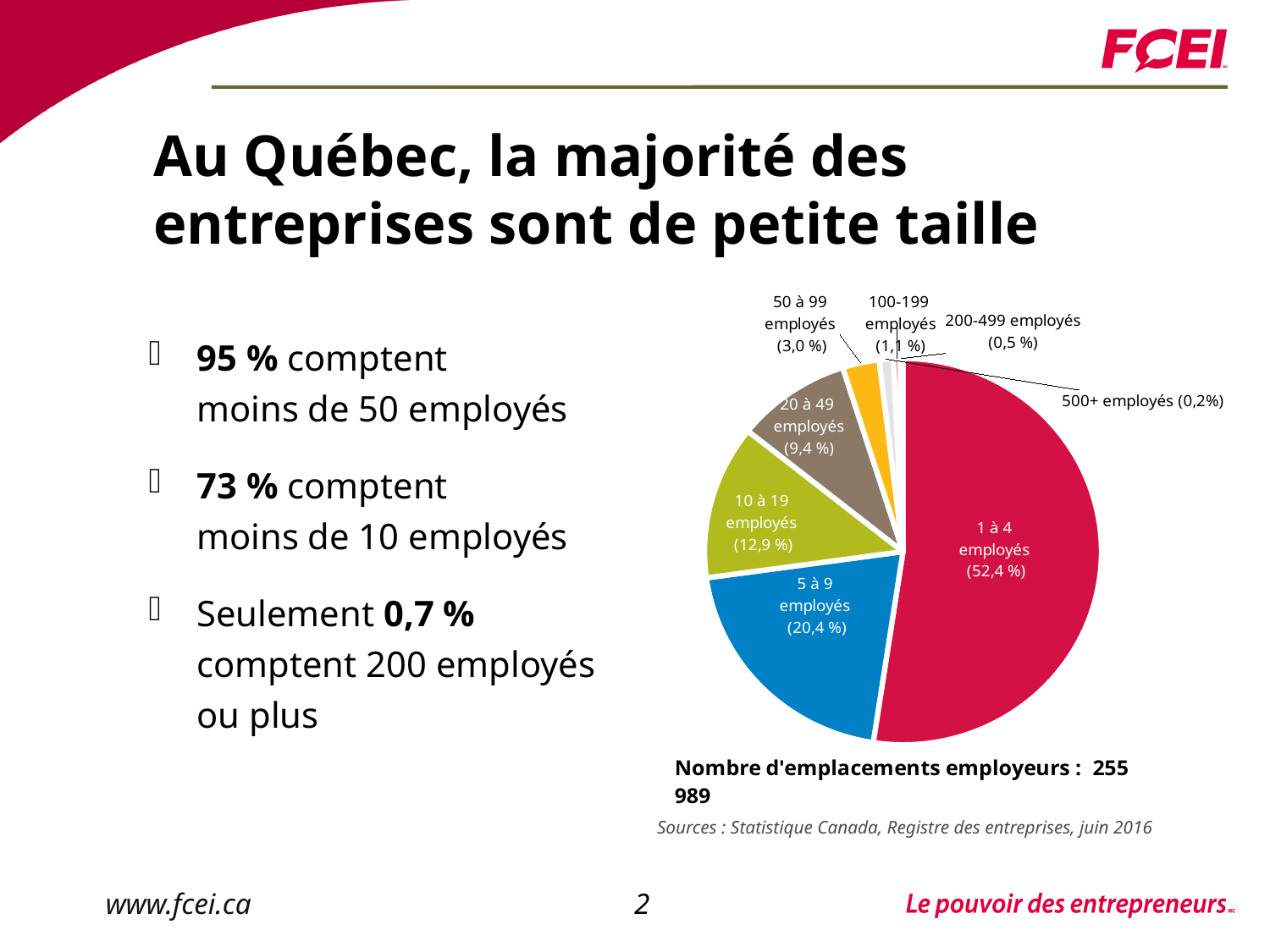
What share of the pie does the "1 à 4 employés" slice represent? 52,4 % How many slices does the pie chart have? 8 What kind of chart is shown on the slide? pie chart Which category has the largest slice of the pie? 1 à 4 employés What is the value shown for "5 à 9 employés"? 20,4 % What is the value shown for "500+ employés"? 0,2 % Which is larger, the value for "50 à 99 employés" or the value for "100-199 employés"? 50 à 99 employés Which category has the smallest slice of the pie? 500+ employés What is the value shown for "10 à 19 employés"? 12,9 % What is the difference between the values for "1 à 4 employés" and "5 à 9 employés"? 32,0 % What total number of employer locations is stated below the pie chart? 255 989 What is the value shown for "20 à 49 employés"? 9,4 %